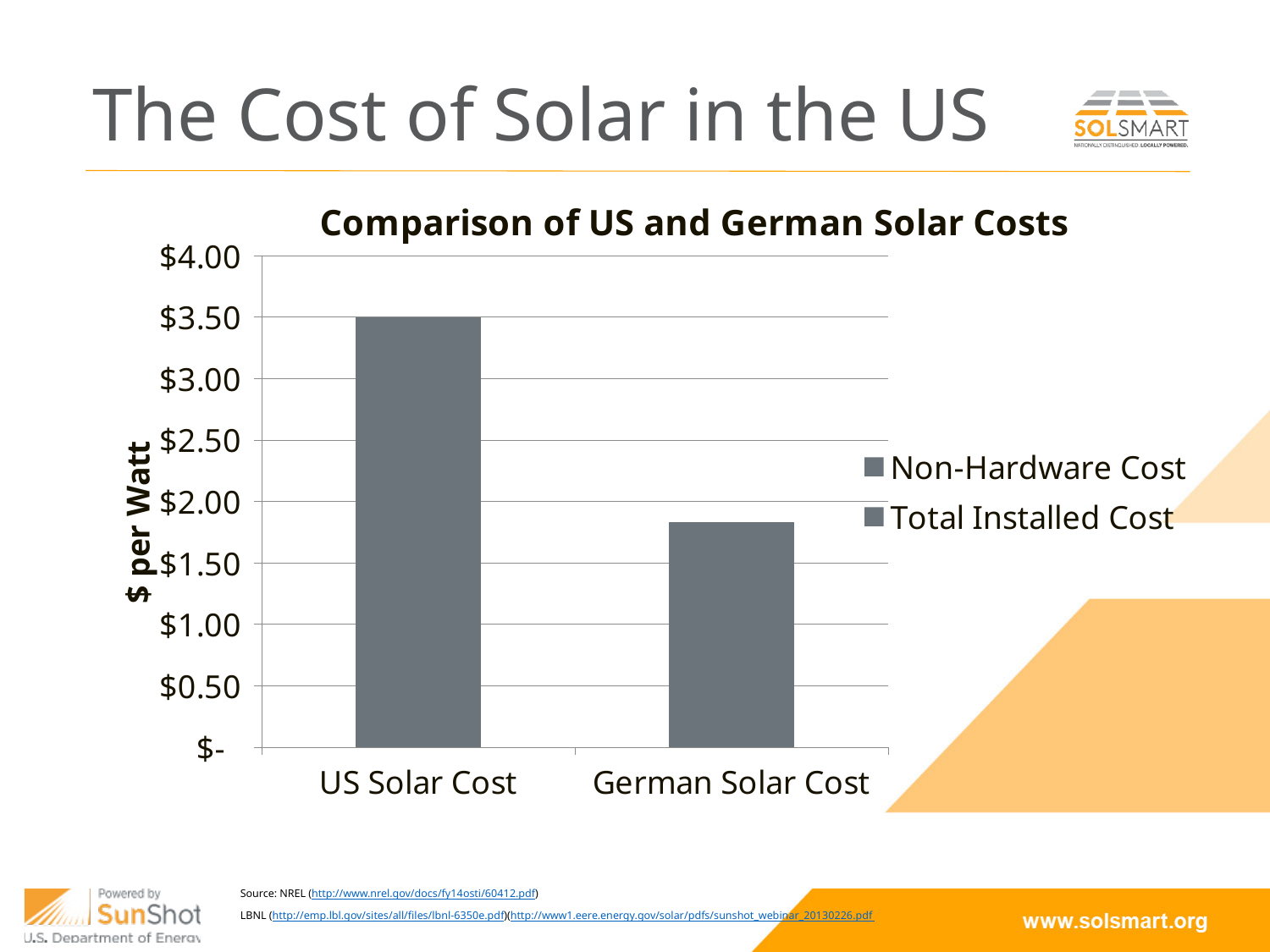
What kind of chart is shown on the slide? bar chart What is the title of the chart? Comparison of US and German Solar Costs Is the value for German Solar Cost greater or less than $2.00? less How many categories are shown on the x axis of the chart? 2 Which category has the lowest bar in the chart? German Solar Cost How many series does the chart's legend list? 2 Which is larger, the bar for US Solar Cost or the bar for German Solar Cost? US Solar Cost Which category has the highest bar in the chart? US Solar Cost Is the value for US Solar Cost greater or less than $3.00? greater What value does the bar for US Solar Cost reach on the y axis? $3.50 Is the value for German Solar Cost greater or less than $1.50? greater Do the bar values rise or fall moving from US Solar Cost to German Solar Cost along the x axis? fall